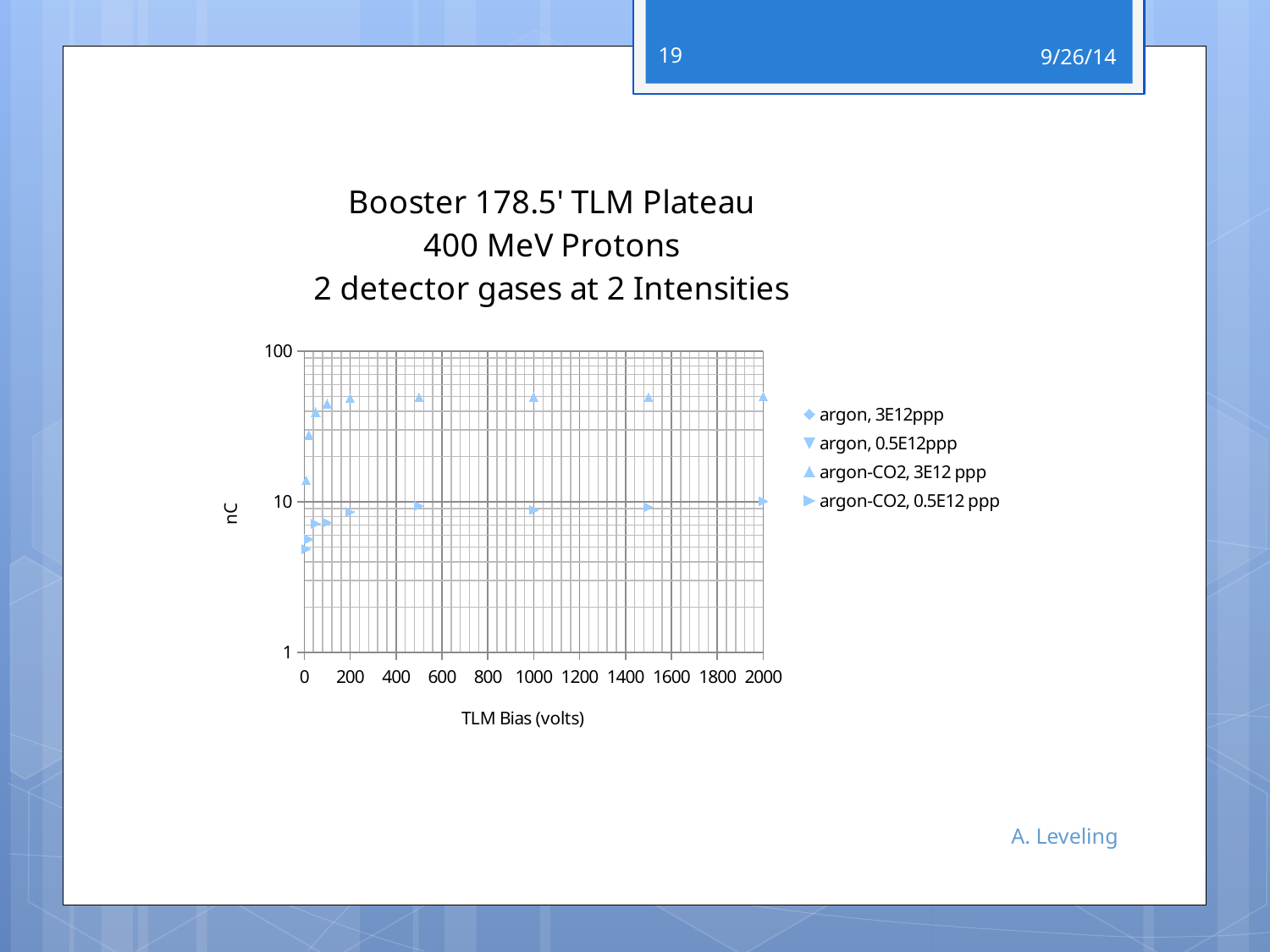
What is the title of the chart? Booster 178.5' TLM Plateau 400 MeV Protons 2 detector gases at 2 Intensities What kind of chart is shown on the slide? scatter chart Is the value for argon-CO2, 0.5E12 ppp at 500 volts greater or less than 1? greater What is the highest tick value shown on the y axis? 100 Is the value for argon-CO2, 3E12 ppp at 2000 volts greater or less than 10? greater How many series does the chart legend list? 4 Do the argon-CO2, 3E12 ppp values rise or fall between 0 and 200 volts? rise What is the label of the x axis? TLM Bias (volts) Is the value for argon-CO2, 0.5E12 ppp at 1500 volts greater or less than 100? less At 1000 volts, which series has the larger value: argon-CO2, 3E12 ppp or argon-CO2, 0.5E12 ppp? argon-CO2, 3E12 ppp